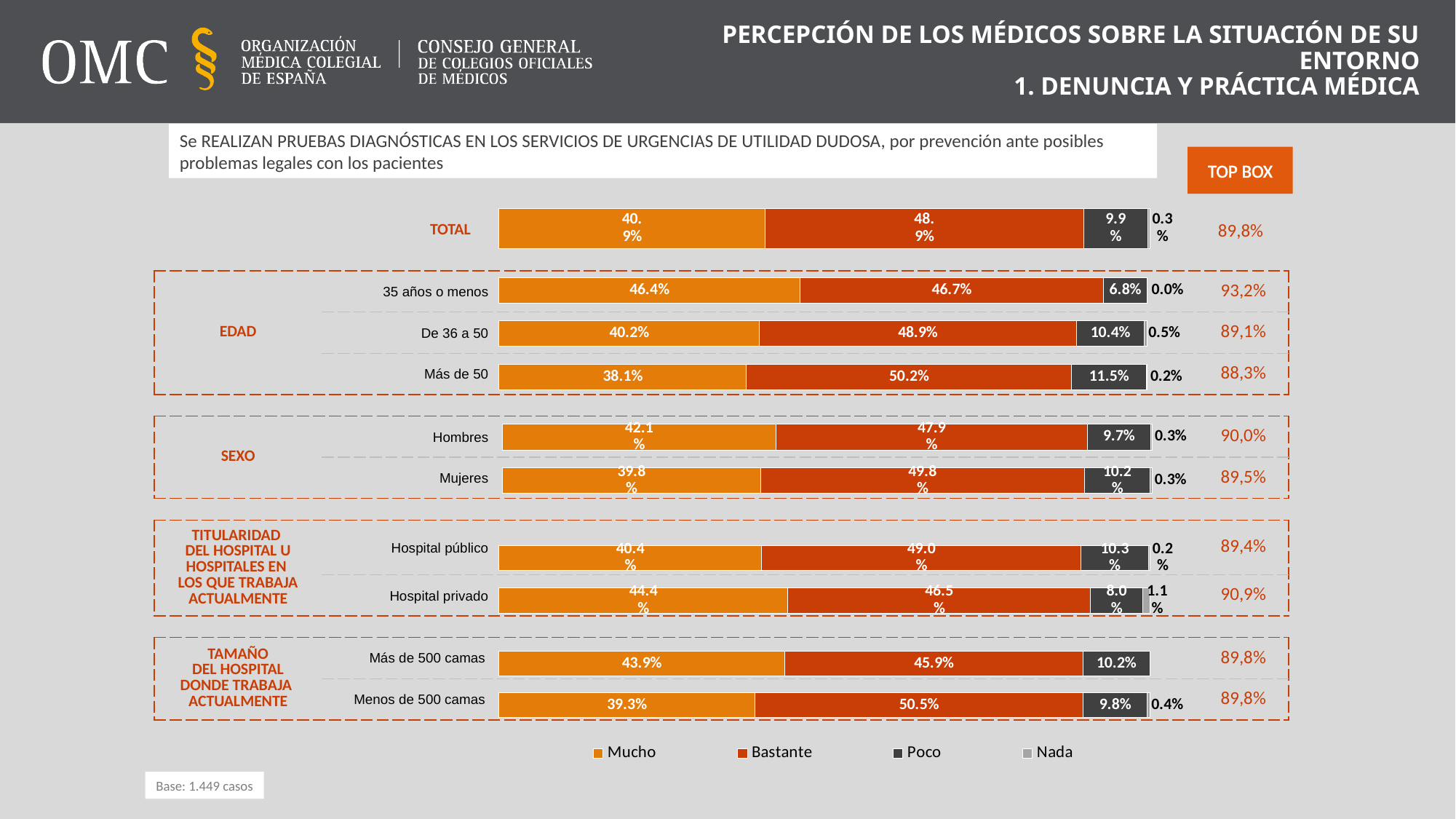
What kind of chart is shown on the slide? Stacked bar chart Which category has the lowest value for Poco? 35 años o menos What is the value of Poco for the category Hospital privado? 8.0% What is the TOP BOX value shown for Hospital privado? 90,9% How many bars (categories) are plotted in the chart? 10 Which has a larger Mucho value, Hombres or Mujeres? Hombres Which category has the highest value for Mucho? 35 años o menos What is the value of Mucho for the category 35 años o menos? 46.4% What is the value of Bastante for the category Más de 50? 50.2% How many series does the legend list? 4 What is the difference between the Bastante values for Mujeres and Hombres? 1.9 percentage points What is the value of Nada for the category De 36 a 50? 0.5%